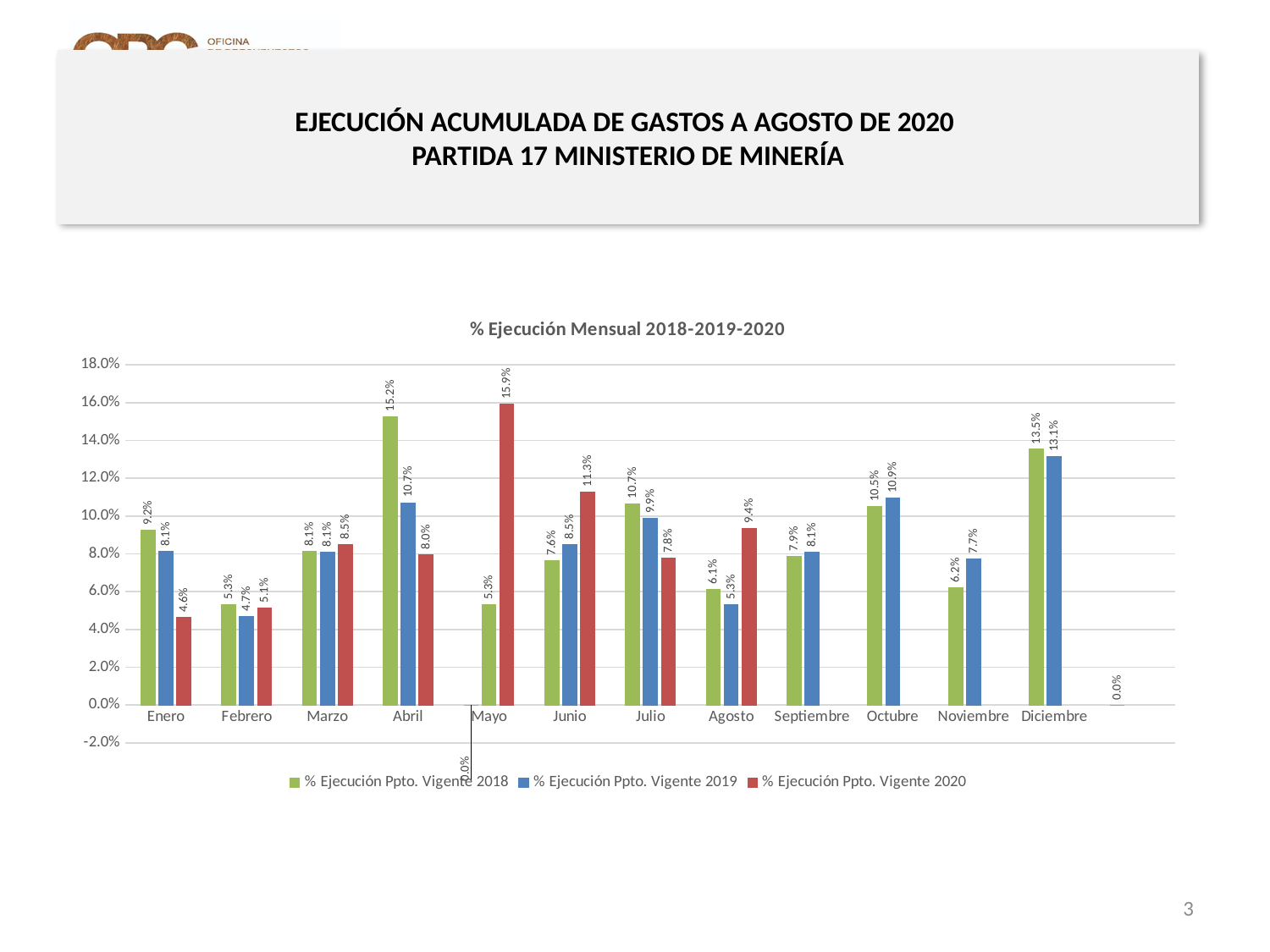
In which month is the % Ejecución Ppto. Vigente 2020 series lowest? Enero What kind of chart is shown on the slide? Bar chart What is the difference between the 2018 and 2019 values for Abril? 4.5 percentage points What is the value of % Ejecución Ppto. Vigente 2020 for Abril? 8.0% What is the value of % Ejecución Ppto. Vigente 2018 for Diciembre? 13.5% What is the title of the chart? % Ejecución Mensual 2018-2019-2020 What is the value of % Ejecución Ppto. Vigente 2019 for Octubre? 10.9% What is the difference between the 2020 and 2018 values for Agosto? 3.3 percentage points In which month is the % Ejecución Ppto. Vigente 2018 series highest? Abril How many series does the legend list? 3 In which month is the % Ejecución Ppto. Vigente 2020 series highest? Mayo For Junio, which is larger: the 2019 value or the 2020 value? 2020 (11.3%)